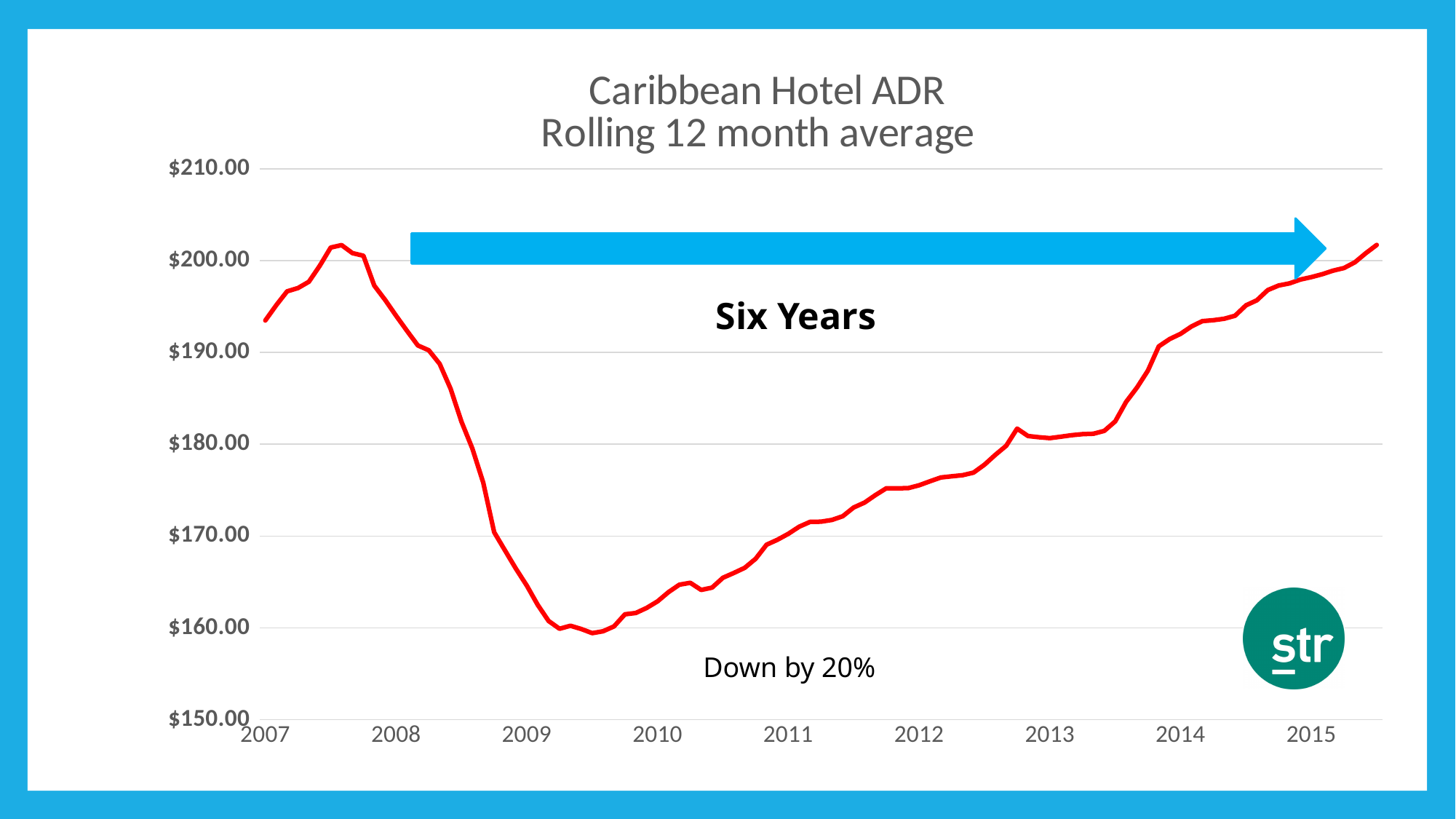
What is the title of the chart? Caribbean Hotel ADR Rolling 12 month average Is the lowest point of the line greater or less than $170.00? less Is the value at the 2012 tick greater or less than $170.00? greater Is the value at the 2015 tick greater or less than $190.00? greater Does the line rise or fall between the 2008 and 2009 ticks? fall What text annotation appears below the low point of the line? Down by 20% Does the line rise or fall between the 2010 and 2015 ticks? rise How many year labels are shown on the x axis? 9 What kind of chart is shown on the slide? line chart In which year labelled on the x axis does the line reach its lowest point? 2009